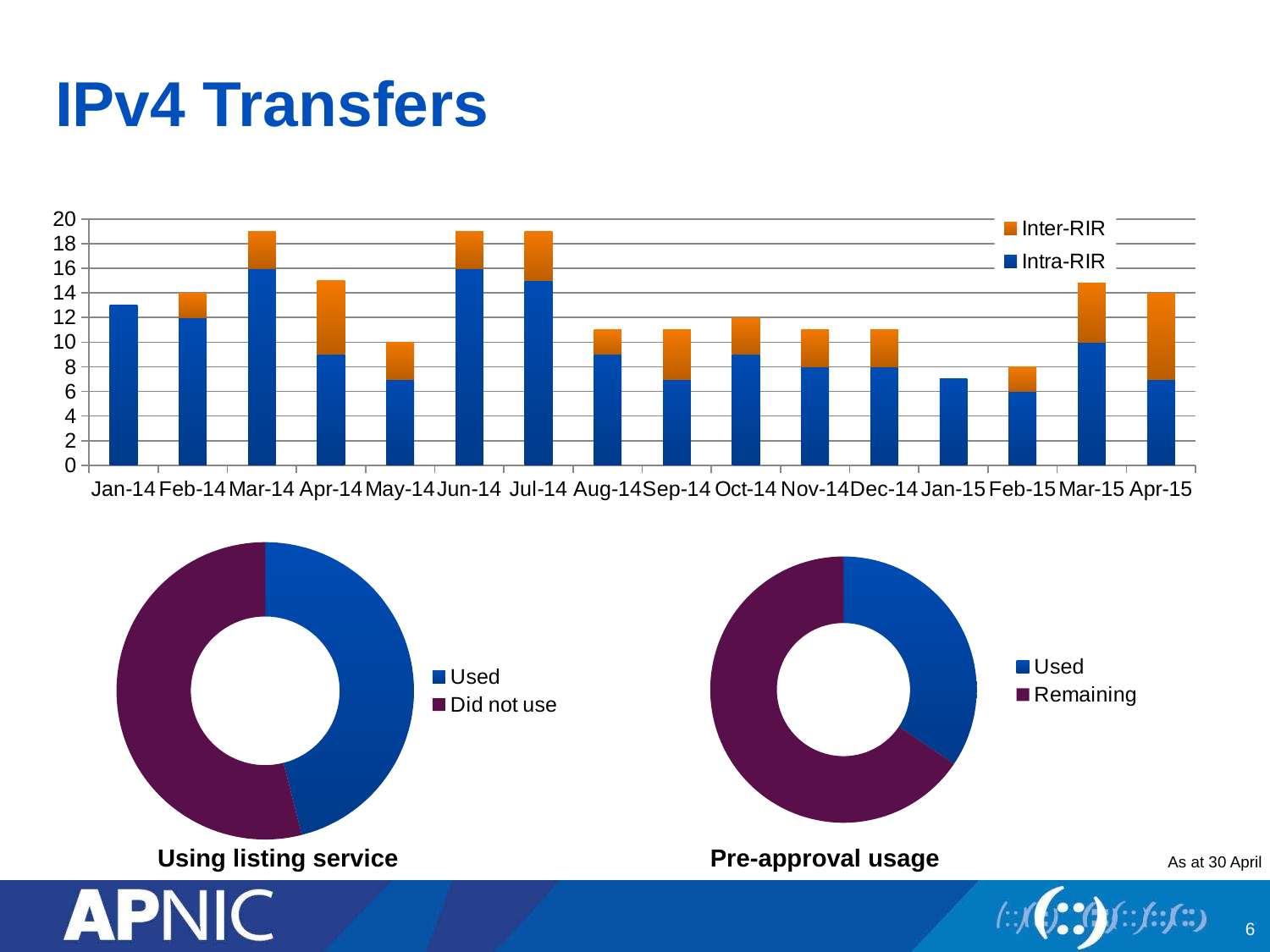
What kind of chart is the top chart on the slide? Stacked bar chart How many series does the legend of the top bar chart list? 2 In the top bar chart, is the total for Jan-15 greater or less than 10? less What are the two legend entries of the 'Pre-approval usage' chart? Used, Remaining How many months are shown on the x axis of the top bar chart? 16 In the top bar chart, do the total bars rise or fall from Jan-14 to Mar-14? rise In the top bar chart, which is larger for Mar-15: the Intra-RIR portion or the Inter-RIR portion? Intra-RIR In the top bar chart, which month has the lowest total bar? Jan-15 In the top bar chart, is the total for Mar-14 greater or less than 16? greater In the 'Pre-approval usage' doughnut chart, which slice is larger: Used or Remaining? Remaining In the 'Using listing service' doughnut chart, which slice is larger: Used or Did not use? Did not use In the top bar chart, is the total for Jan-14 greater or less than 10? greater